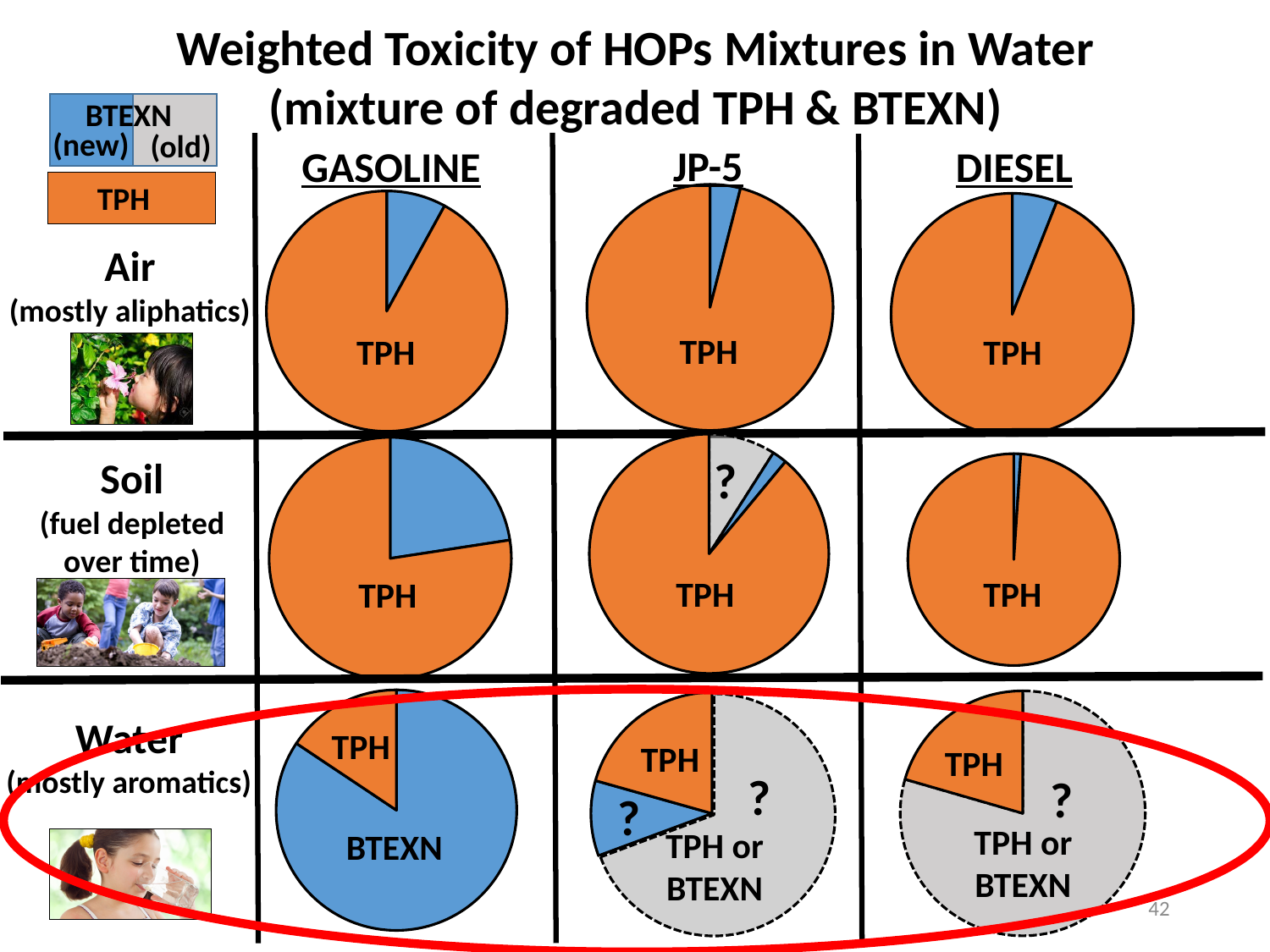
In the Soil row, which fuel's pie chart has the smallest BTEXN slice? Diesel In the Soil row, which fuel's pie chart has the largest BTEXN slice? Gasoline In the Air row, which fuel's pie chart has the largest BTEXN slice? Gasoline In the Air row, Gasoline pie chart, which is the larger slice, TPH or BTEXN? TPH What kind of charts are shown on the slide? Pie charts For Gasoline, in which row (Air, Soil or Water) does BTEXN take the largest share of the pie? Water How many fuel types (columns) are compared on the slide? 3 According to the legend, what colour represents TPH in the pie charts? Orange In the Water row, Gasoline pie chart, which is the larger slice, TPH or BTEXN? BTEXN What is the title of the slide's chart grid? Weighted Toxicity of HOPs Mixtures in Water (mixture of degraded TPH & BTEXN) How many pie charts are shown on the slide? 9 In the Water row, Diesel pie chart, which is the larger slice, TPH or the grey 'TPH or BTEXN' slice? TPH or BTEXN